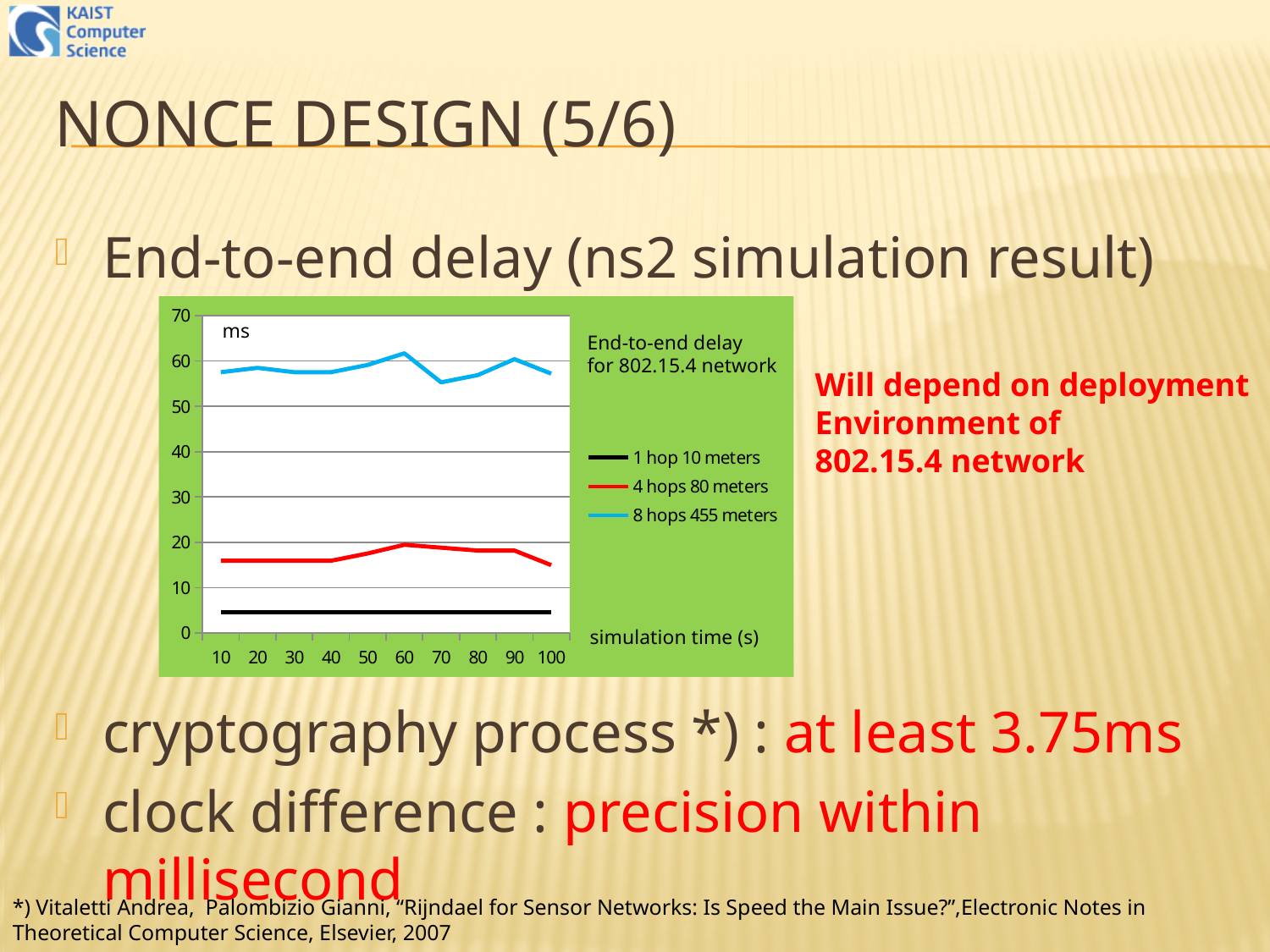
Is the end-to-end delay for 1 hop 10 meters at simulation time 50 greater or less than 10? less How many series does the chart legend list? 3 Is the end-to-end delay for 8 hops 455 meters at simulation time 60 greater or less than 50? greater What unit is shown on the y axis of the chart? ms Is the end-to-end delay for 8 hops 455 meters at simulation time 70 greater or less than 60? less What kind of chart is shown on the slide? line chart What colour is the line for the 8 hops 455 meters series? blue Which is larger at simulation time 100: the delay for 4 hops 80 meters or the delay for 1 hop 10 meters? 4 hops 80 meters Which series has the lowest end-to-end delay throughout the simulation? 1 hop 10 meters How many simulation time points are plotted along the x axis? 10 Which series has the highest end-to-end delay throughout the simulation? 8 hops 455 meters